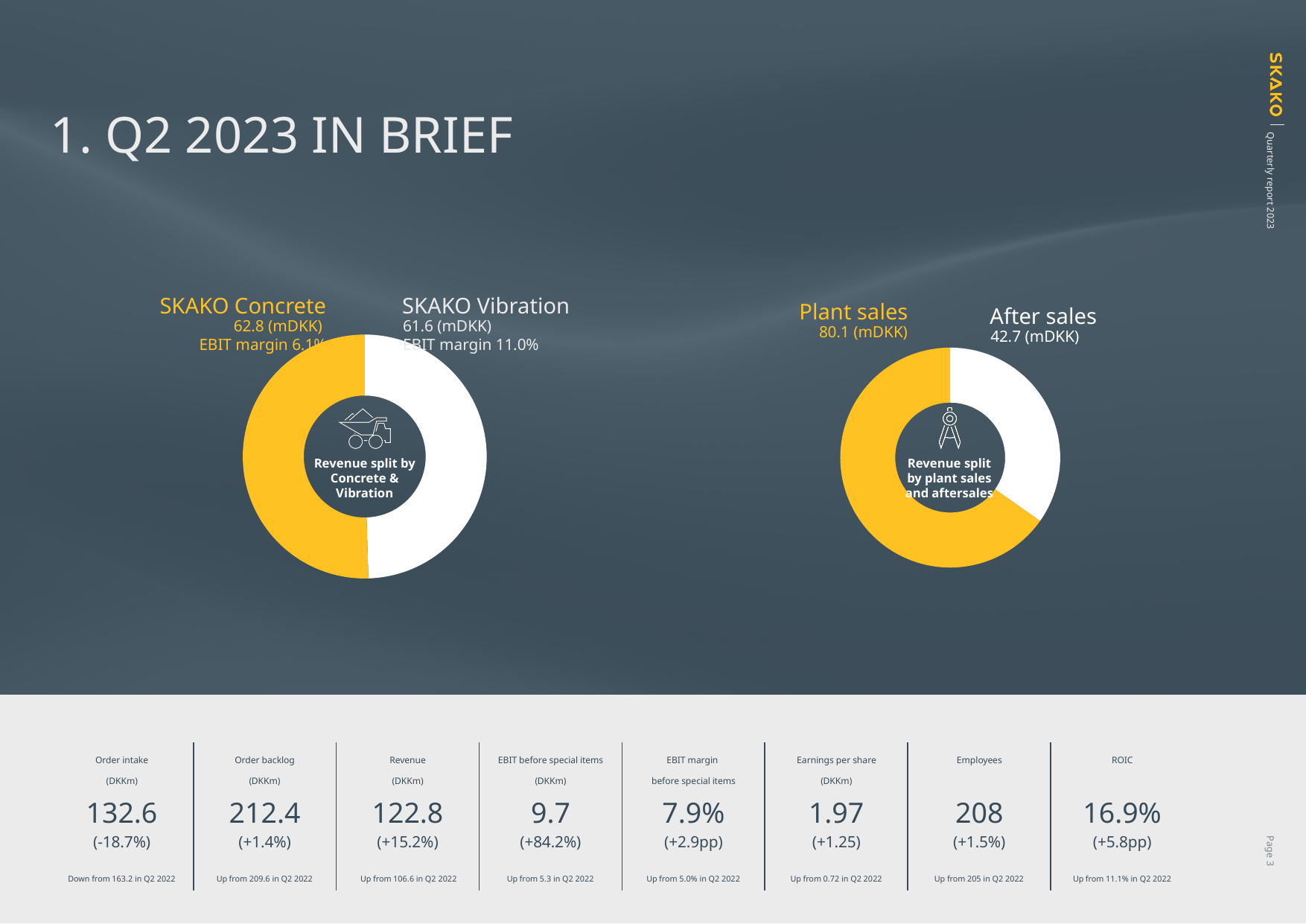
In the 'Revenue split by Concrete & Vibration' chart, what is the revenue for SKAKO Vibration? 61.6 (mDKK) In the 'Revenue split by Concrete & Vibration' chart, what is the difference between SKAKO Concrete and SKAKO Vibration revenue in mDKK? 1.2 In the 'Revenue split by plant sales and aftersales' chart, what is the total of Plant sales and After sales in mDKK? 122.8 In the 'Revenue split by Concrete & Vibration' chart, which segment has the higher revenue? SKAKO Concrete In the 'Revenue split by Concrete & Vibration' chart, what colour is the SKAKO Concrete segment? Yellow In the 'Revenue split by Concrete & Vibration' chart, what is the revenue for SKAKO Concrete? 62.8 (mDKK) What type of chart is used for the 'Revenue split by Concrete & Vibration'? Donut (pie) chart In the 'Revenue split by plant sales and aftersales' chart, what is the difference between Plant sales and After sales in mDKK? 37.4 In the 'Revenue split by plant sales and aftersales' chart, which segment is larger, Plant sales or After sales? Plant sales In the 'Revenue split by plant sales and aftersales' chart, what is the value for After sales? 42.7 (mDKK) How many segments does the 'Revenue split by plant sales and aftersales' chart have? 2 In the 'Revenue split by plant sales and aftersales' chart, what is the value for Plant sales? 80.1 (mDKK)